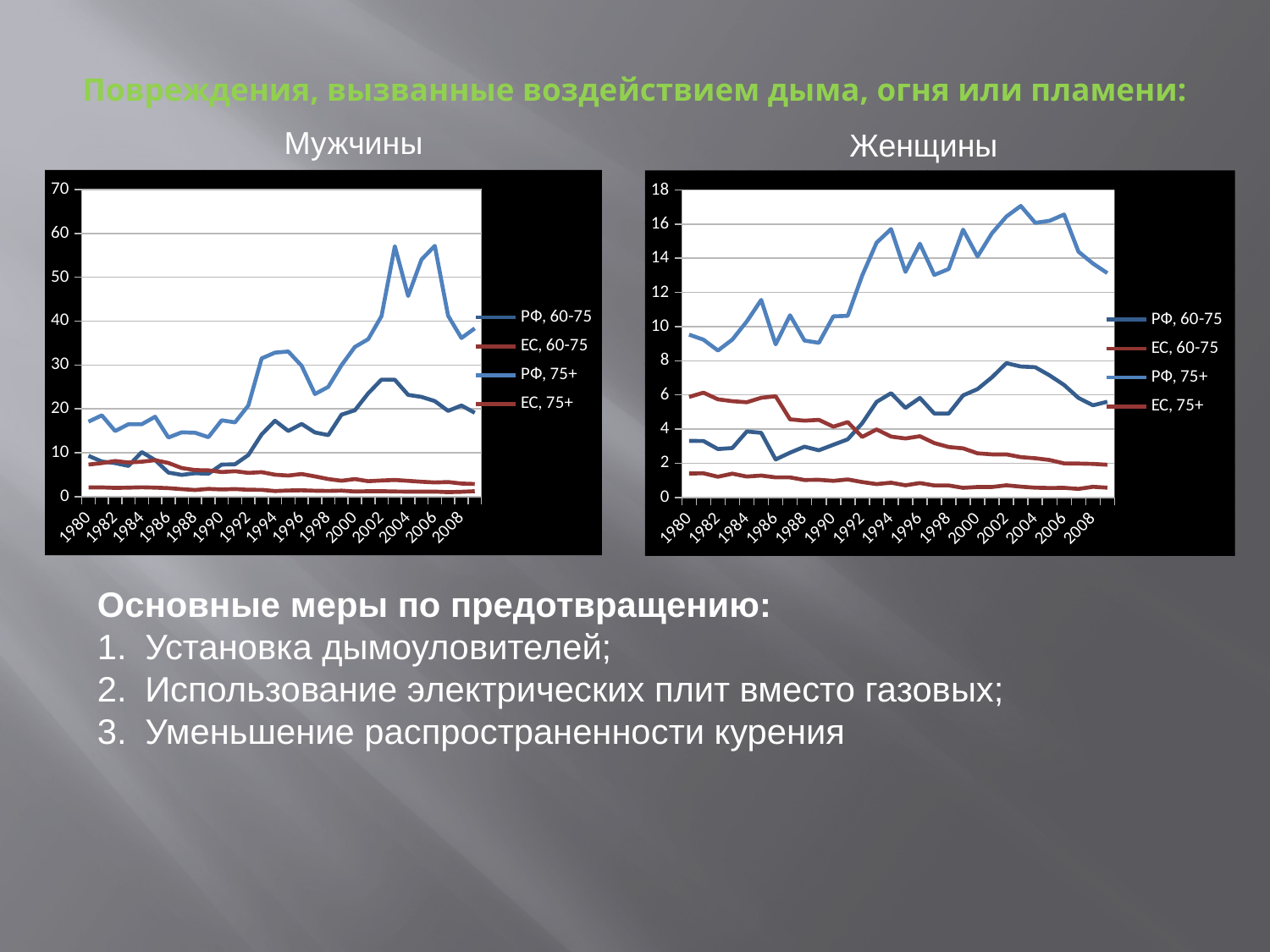
In the "Мужчины" chart, is the value for ЕС, 75+ in 2008 greater or less than 10? less What kind of chart is the "Мужчины" chart? line chart In the "Женщины" chart, which is larger in 1980: ЕС, 60-75 or РФ, 60-75? РФ, 60-75 In the "Женщины" chart, is the value for ЕС, 60-75 in 1980 greater or less than 4? less In the "Женщины" chart, which series has the lowest values across the whole period? ЕС, 60-75 How many series does the legend of the "Женщины" chart list? 4 In the "Мужчины" chart, is the value for РФ, 75+ in 2003 greater or less than 50? greater In the "Мужчины" chart, which series has the highest value in 2003? РФ, 75+ In the "Мужчины" chart, which is larger in 2008: РФ, 75+ or ЕС, 75+? РФ, 75+ In the "Мужчины" chart, does the ЕС, 60-75 series rise or fall from 1980 to 2008? fall What is the title of the slide above the two charts? Повреждения, вызванные воздействием дыма, огня или пламени: